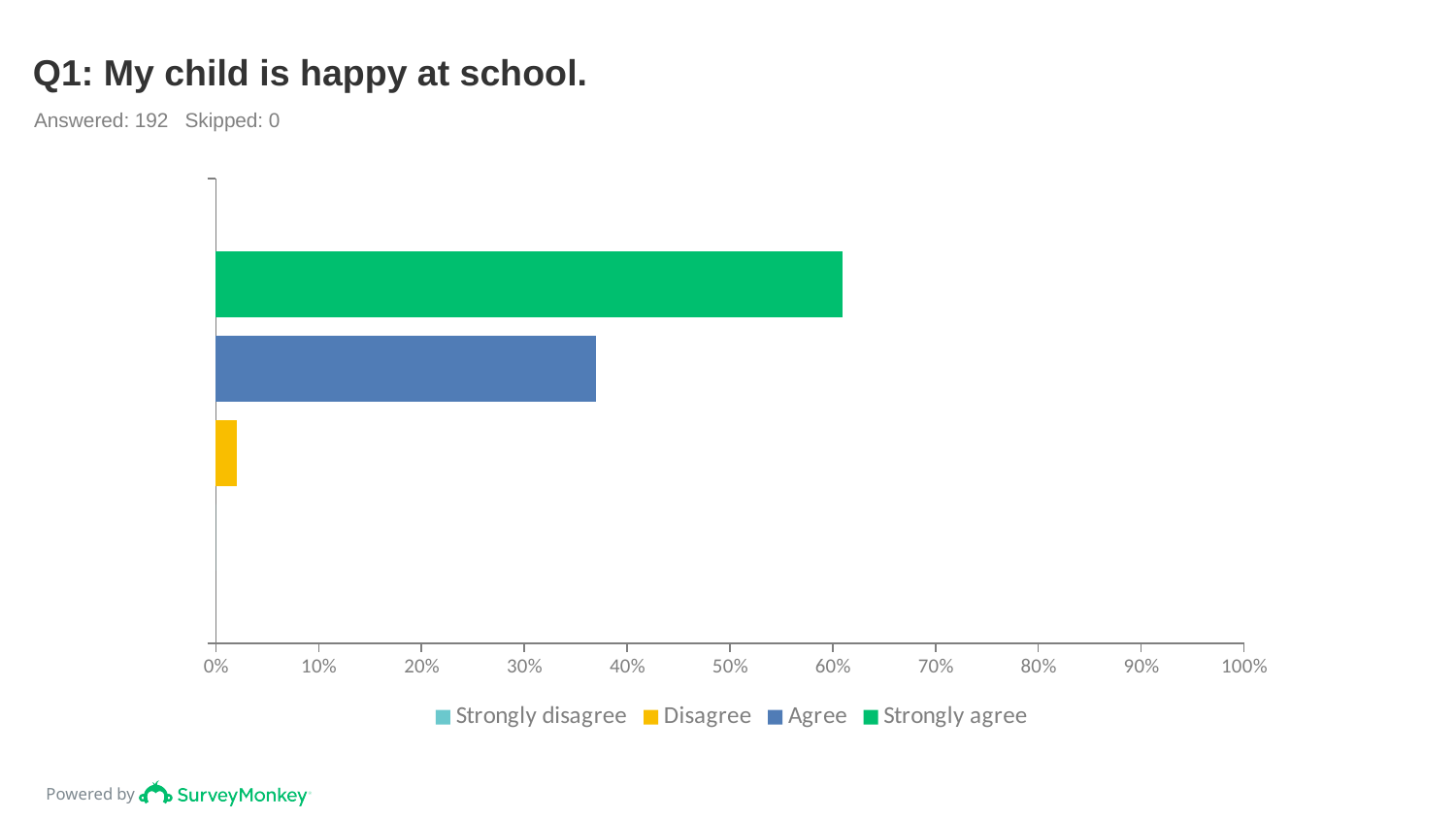
What is the title of the chart? Q1: My child is happy at school. How many respondents answered the question according to the slide? 192 How many series does the legend list? 4 Is the value for Disagree greater or less than 10%? less Which response option has the highest value? Strongly agree Which is larger, the value for Disagree or the value for Agree? Agree What kind of chart is shown on the slide? Bar chart Is the value for Strongly agree greater or less than 50%? greater Is the value for Agree greater or less than 40%? less Which response option has the lowest value? Strongly disagree Which is larger, the value for Agree or the value for Strongly agree? Strongly agree